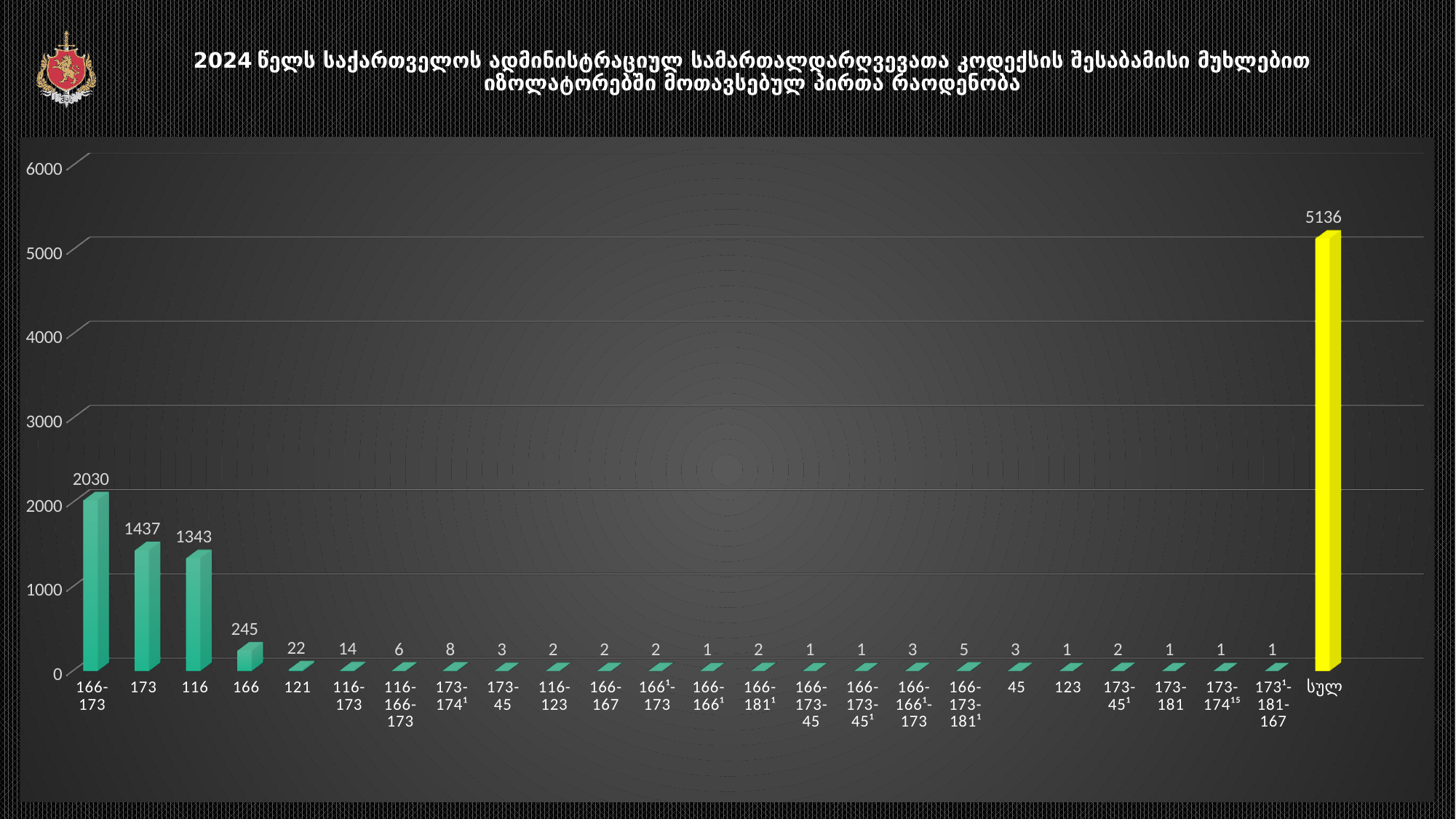
What is the value for the category "173"? 1437 What is the value for the category "116"? 1343 What is the difference between the values for "166-173" and "173"? 593 How many bars are plotted on the chart, including the "სულ" bar? 25 Which is larger, the value for "173" or the value for "116"? 173 What is the value for the category "166"? 245 What is the value for the category "121"? 22 What is the value for the category "166-173"? 2030 What type of chart is shown on the slide? bar chart What is the value shown for the yellow bar labelled "სულ"? 5136 Is the value for "166-173" greater or less than 2000? greater Excluding the "სულ" total bar, which category has the highest value? 166-173